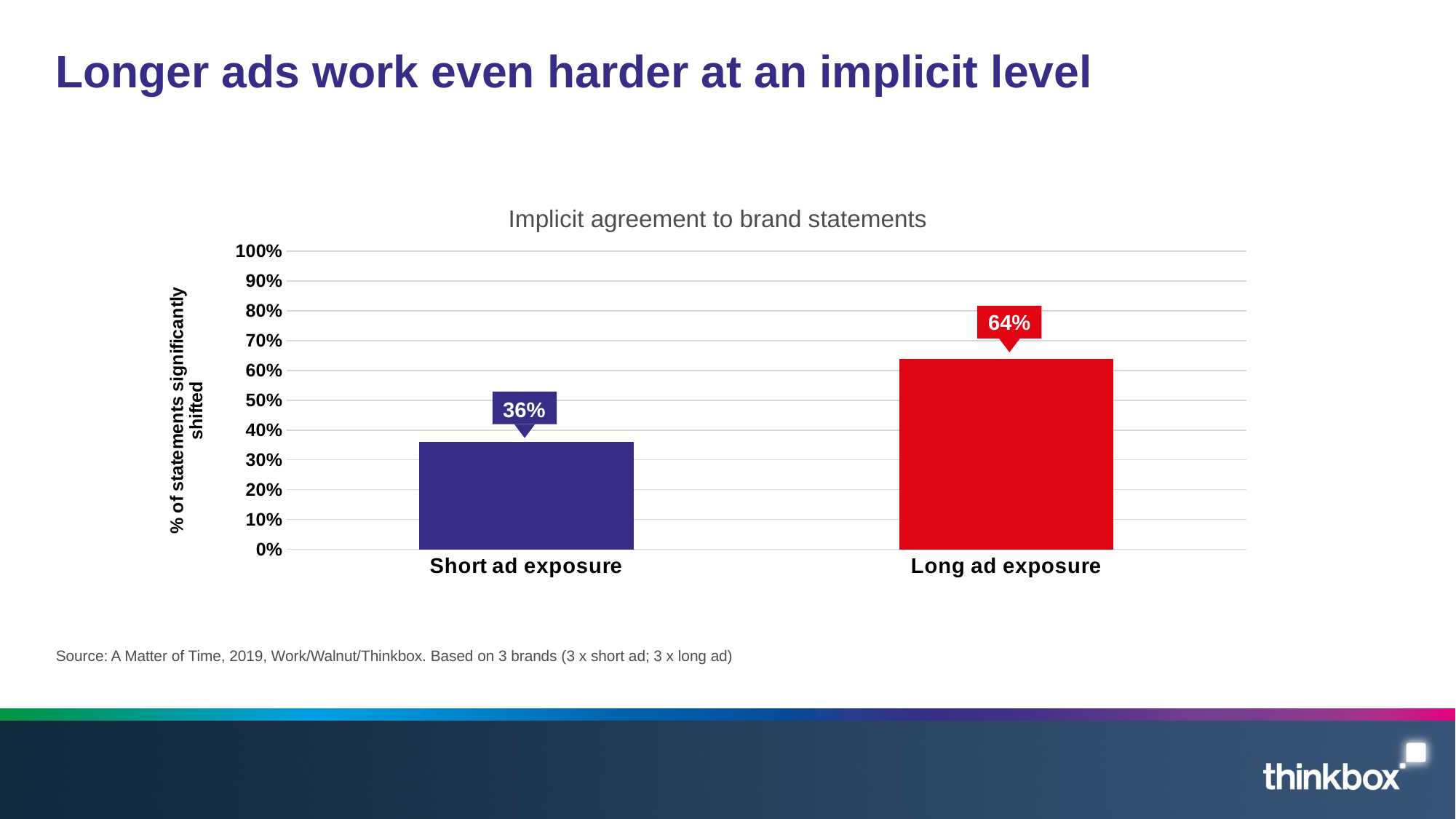
Which category has the lowest value? Short ad exposure What is the difference between the values for Long ad exposure and Short ad exposure? 28% What is the value for Long ad exposure? 64% What is the title of the chart? Implicit agreement to brand statements How many categories are shown on the x axis? 2 Which category has the highest value? Long ad exposure Is the value for Long ad exposure greater or less than 50%? greater What is the label of the vertical axis? % of statements significantly shifted Is the value for Short ad exposure greater or less than 40%? less What kind of chart is shown on the slide? Bar chart What is the value for Short ad exposure? 36% Which is larger, the value for Short ad exposure or Long ad exposure? Long ad exposure